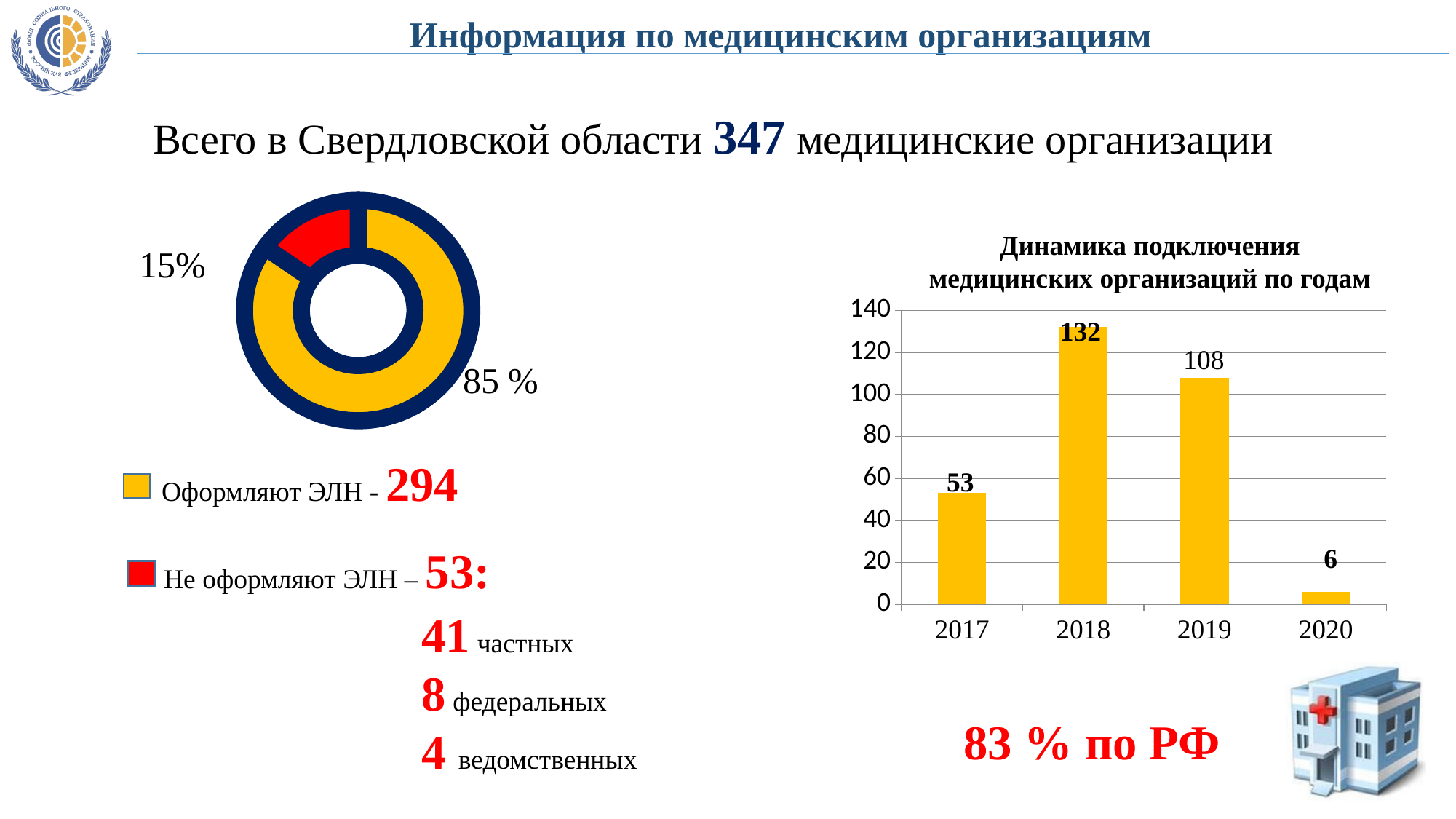
In the bar chart 'Динамика подключения медицинских организаций по годам', which is larger, the value for 2017 or the value for 2019? 2019 In the bar chart 'Динамика подключения медицинских организаций по годам', which year has the highest value? 2018 In the bar chart 'Динамика подключения медицинских организаций по годам', what is the value for 2018? 132 In the bar chart 'Динамика подключения медицинских организаций по годам', which year has the lowest value? 2020 What kind of chart is the chart titled 'Динамика подключения медицинских организаций по годам'? bar chart In the donut chart on the left, what share is shown for the yellow slice? 85 % In the donut chart on the left, what share is shown for the red slice? 15% In the bar chart 'Динамика подключения медицинских организаций по годам', what is the difference between the values for 2018 and 2019? 24 In the bar chart 'Динамика подключения медицинских организаций по годам', how many years are shown on the x axis? 4 In the bar chart 'Динамика подключения медицинских организаций по годам', do the values rise or fall from 2018 to 2020? fall In the bar chart 'Динамика подключения медицинских организаций по годам', what is the value for 2019? 108 In the bar chart 'Динамика подключения медицинских организаций по годам', what is the value for 2020? 6